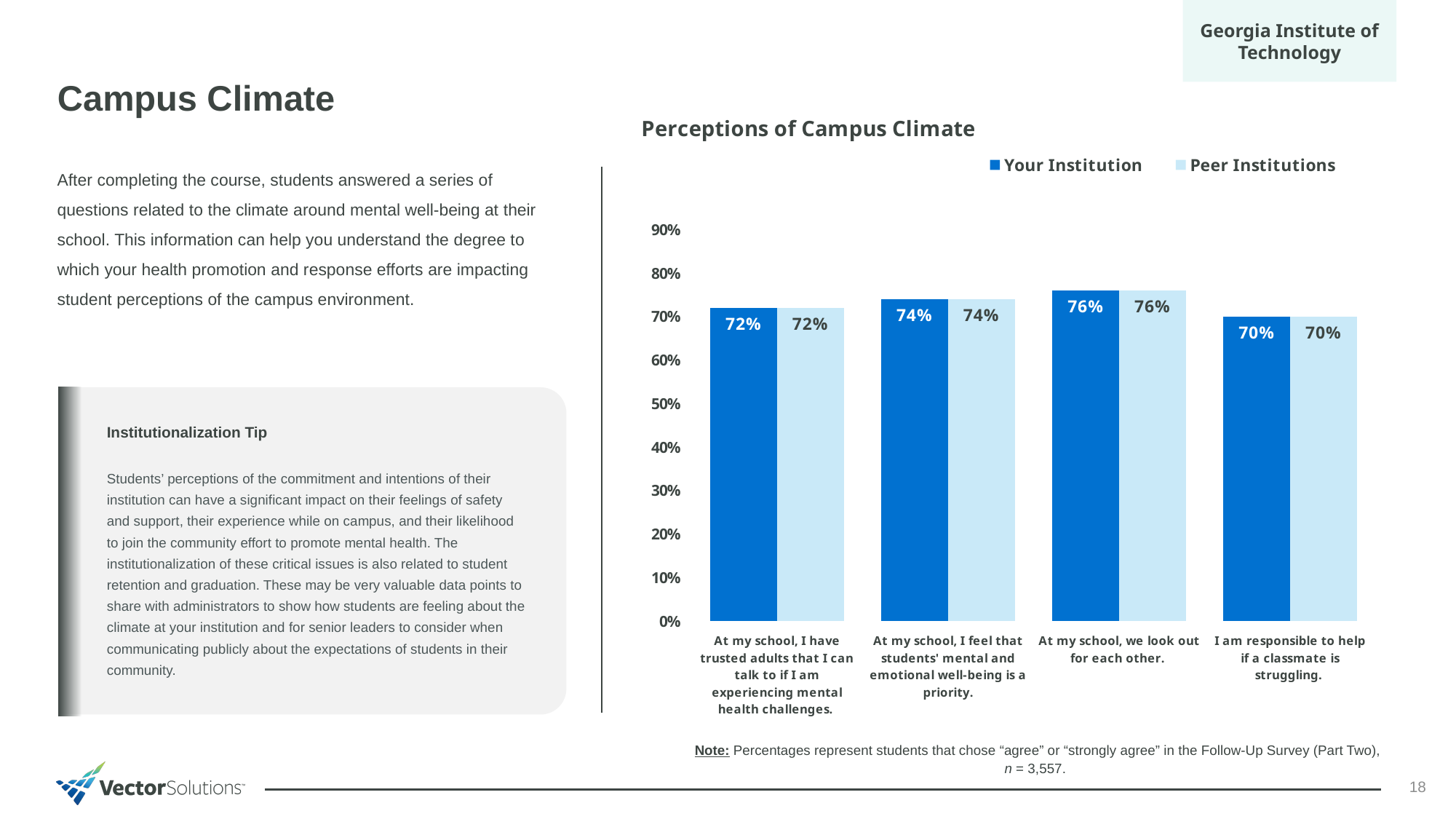
What is the value for Peer Institutions for "I am responsible to help if a classmate is struggling."? 70% What is the difference between the Your Institution values for "At my school, we look out for each other." and "I am responsible to help if a classmate is struggling."? 6% What kind of chart is shown? Bar chart What is the value for Peer Institutions for "At my school, I feel that students' mental and emotional well-being is a priority."? 74% How many series does the legend list? 2 Which category has the highest value for Your Institution? At my school, we look out for each other. How many categories are shown on the x axis? 4 What is the title of the chart? Perceptions of Campus Climate Is the Your Institution value for "At my school, I feel that students' mental and emotional well-being is a priority." greater or less than 70%? greater What is the value for Your Institution for "At my school, I have trusted adults that I can talk to if I am experiencing mental health challenges."? 72% What is the value for Your Institution for "At my school, we look out for each other."? 76% Which category has the lowest value for Peer Institutions? I am responsible to help if a classmate is struggling.